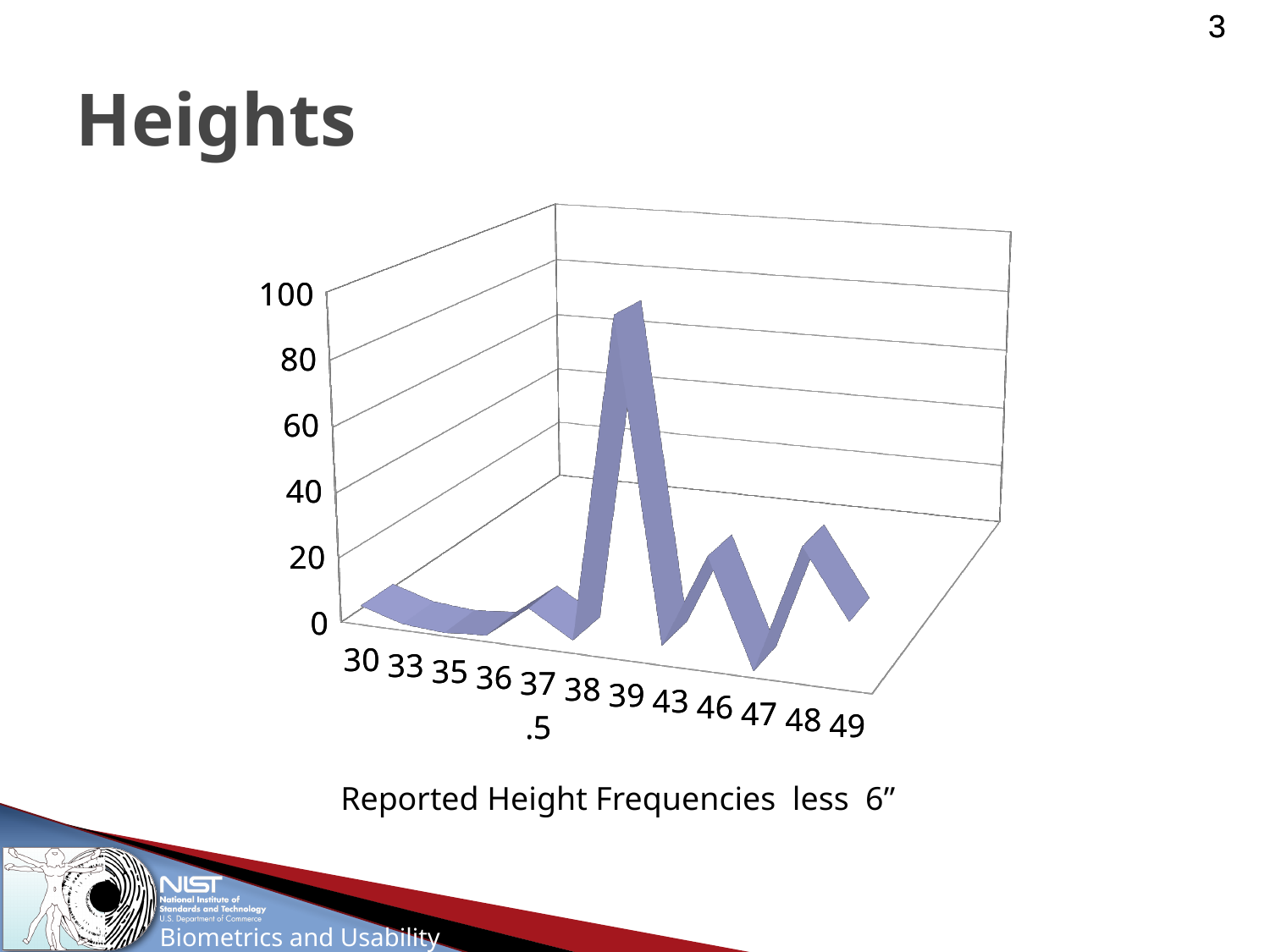
What is the highest tick value shown on the vertical axis of the chart? 100 Is the value for 30 greater or less than 20? less Which category has the highest value in the chart? 39 How many categories are shown along the x axis of the chart? 12 What kind of chart is shown on the slide? line chart Is the value for 38 greater or less than 60? less Is the value for 43 greater or less than 20? less What caption appears below the chart? Reported Height Frequencies less 6" Which is larger, the value for 38 or the value for 46? 46